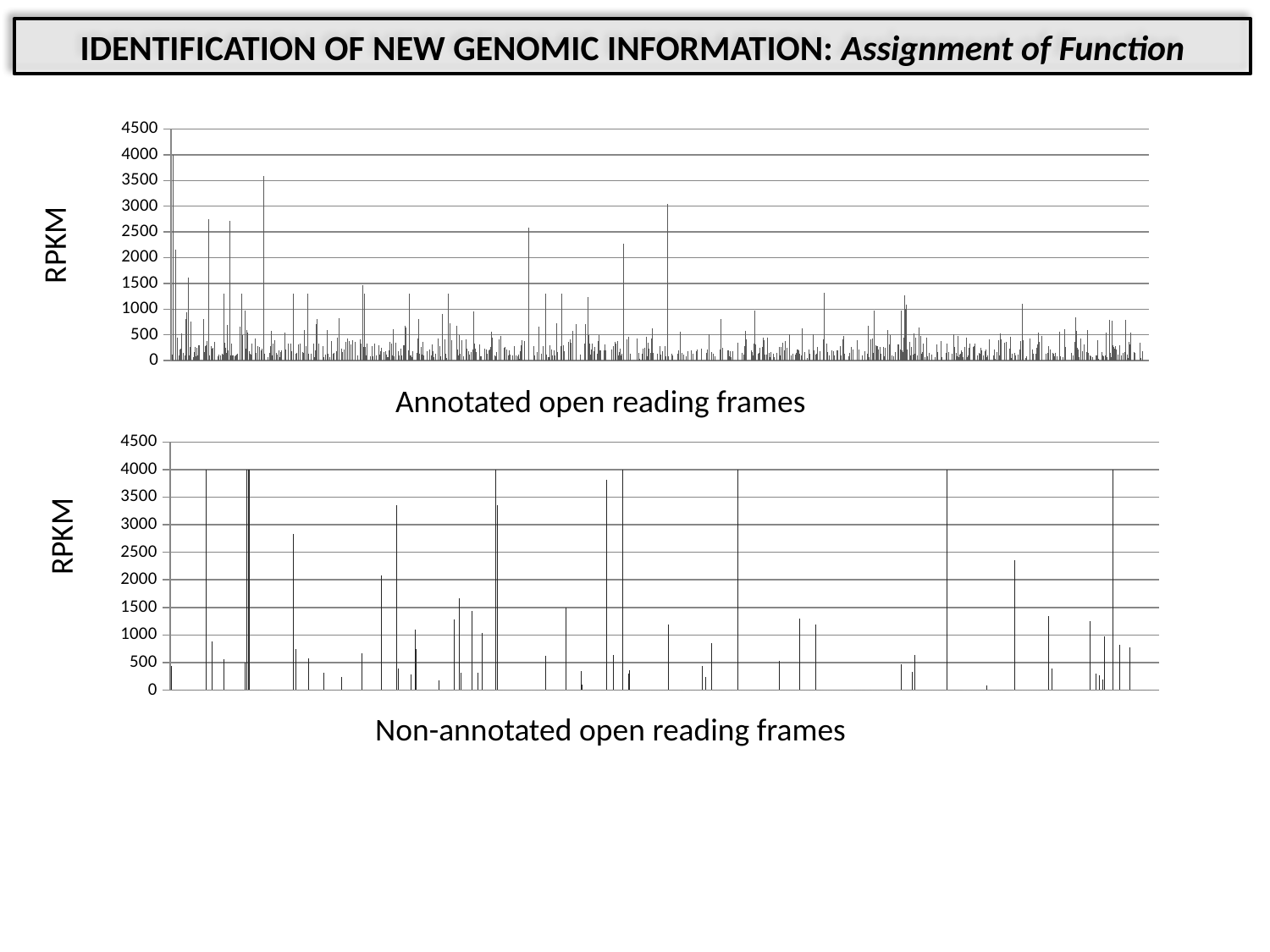
What is the y-axis label of the top chart? RPKM What caption appears below the bottom chart? Non-annotated open reading frames What kind of chart is the bottom chart, labelled 'Non-annotated open reading frames'? bar chart What is the highest tick value on the y-axis of the top chart? 4500 How many charts are shown on the slide? 2 In the top chart, is the tallest bar greater or less than 3500? greater In the bottom chart, is the tallest bar greater or less than 3000? greater What kind of chart is the top chart, labelled 'Annotated open reading frames'? bar chart